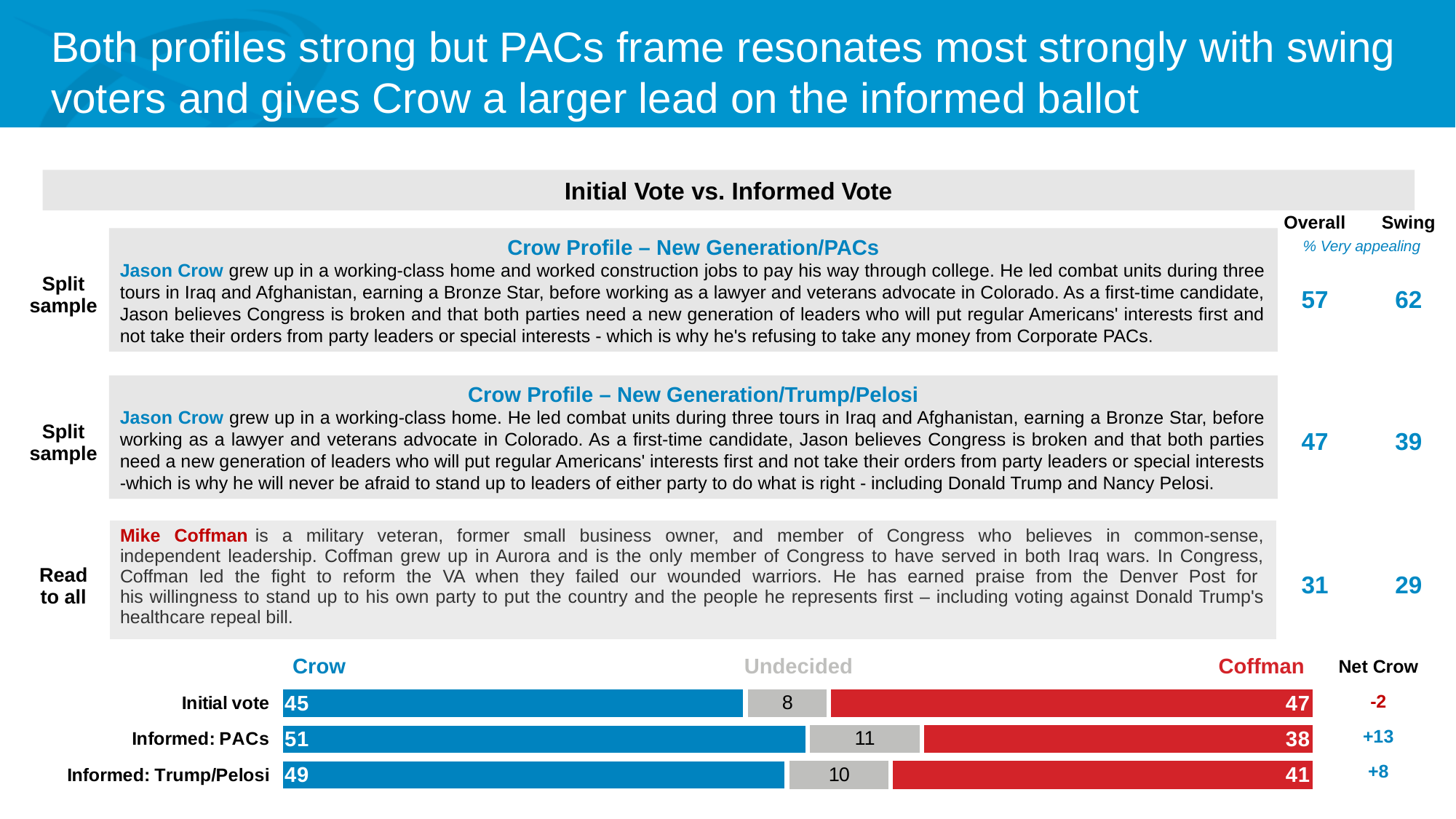
What kind of chart is shown at the bottom of the slide? Stacked bar chart How many bars (categories) does the chart show? 3 What is the Net Crow value shown for Informed: PACs? +13 What is the Undecided value for the Informed: Trump/Pelosi bar? 10 Is the Crow value larger for Informed: PACs or for Informed: Trump/Pelosi? Informed: PACs Which bar has the lowest Undecided value? Initial vote How many series does the chart show? 3 What is the total of the Initial vote bar (Crow + Undecided + Coffman)? 100 Which bar has the highest Crow value? Informed: PACs What is the Crow value for the Initial vote bar? 45 What is the Coffman value for the Informed: PACs bar? 38 What is the difference between the Coffman value for Initial vote and the Coffman value for Informed: PACs? 9